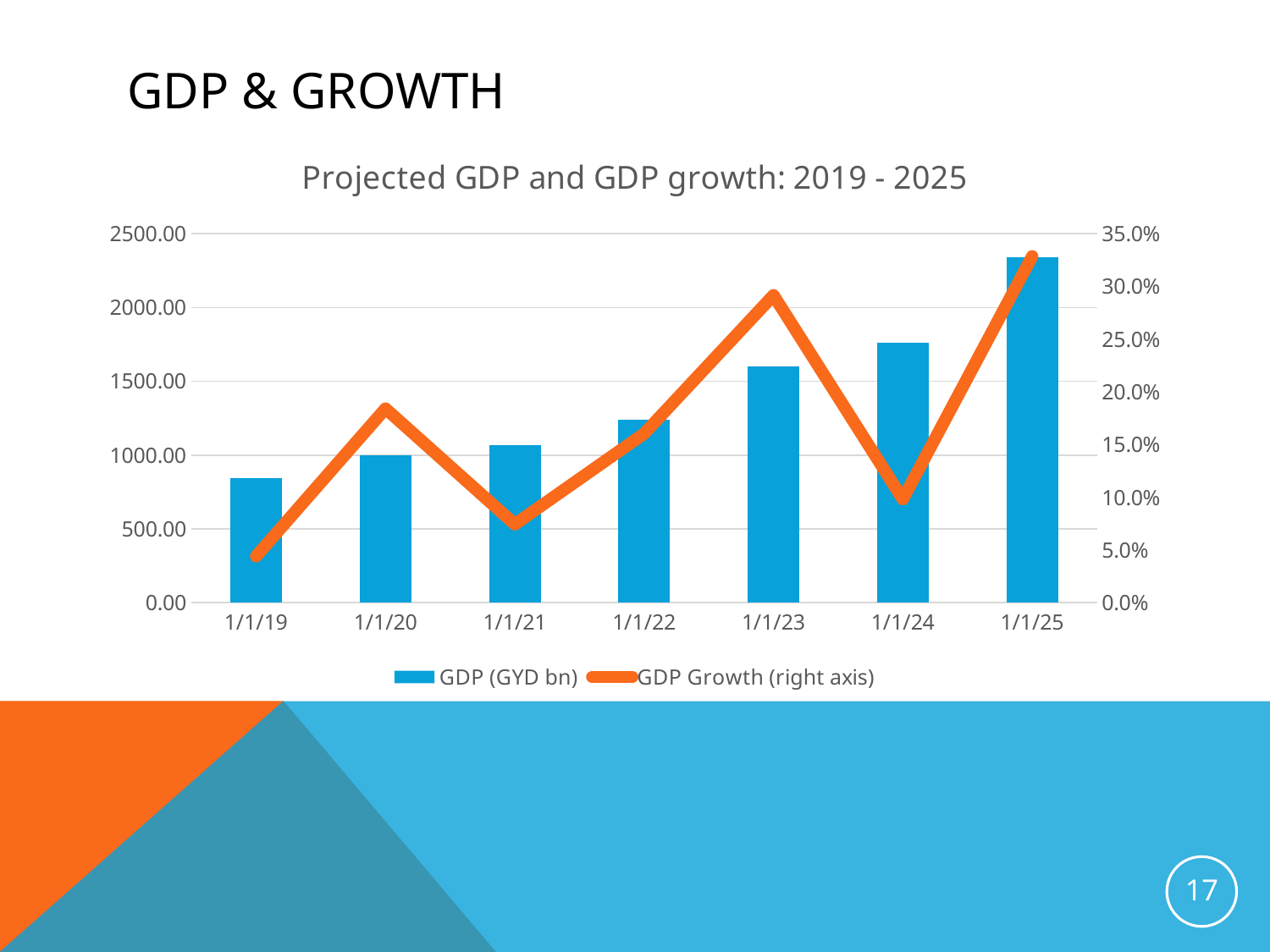
Which date has the highest GDP (GYD bn) bar? 1/1/25 Is the GDP (GYD bn) value for 1/1/23 greater or less than 1500.00? greater Do the GDP (GYD bn) bars rise or fall from 1/1/19 to 1/1/25? rise Which date has the highest GDP Growth value? 1/1/25 How many dates are shown on the x axis? 7 What is the title of the chart? Projected GDP and GDP growth: 2019 - 2025 Which date has the lowest GDP Growth value? 1/1/19 Which date has the lowest GDP (GYD bn) bar? 1/1/19 How many series does the legend list? 2 What kind of chart is shown on the slide? A combination bar and line chart Which is larger, the GDP Growth value for 1/1/20 or for 1/1/24? 1/1/20 Is the GDP Growth value for 1/1/21 greater or less than 10.0%? less